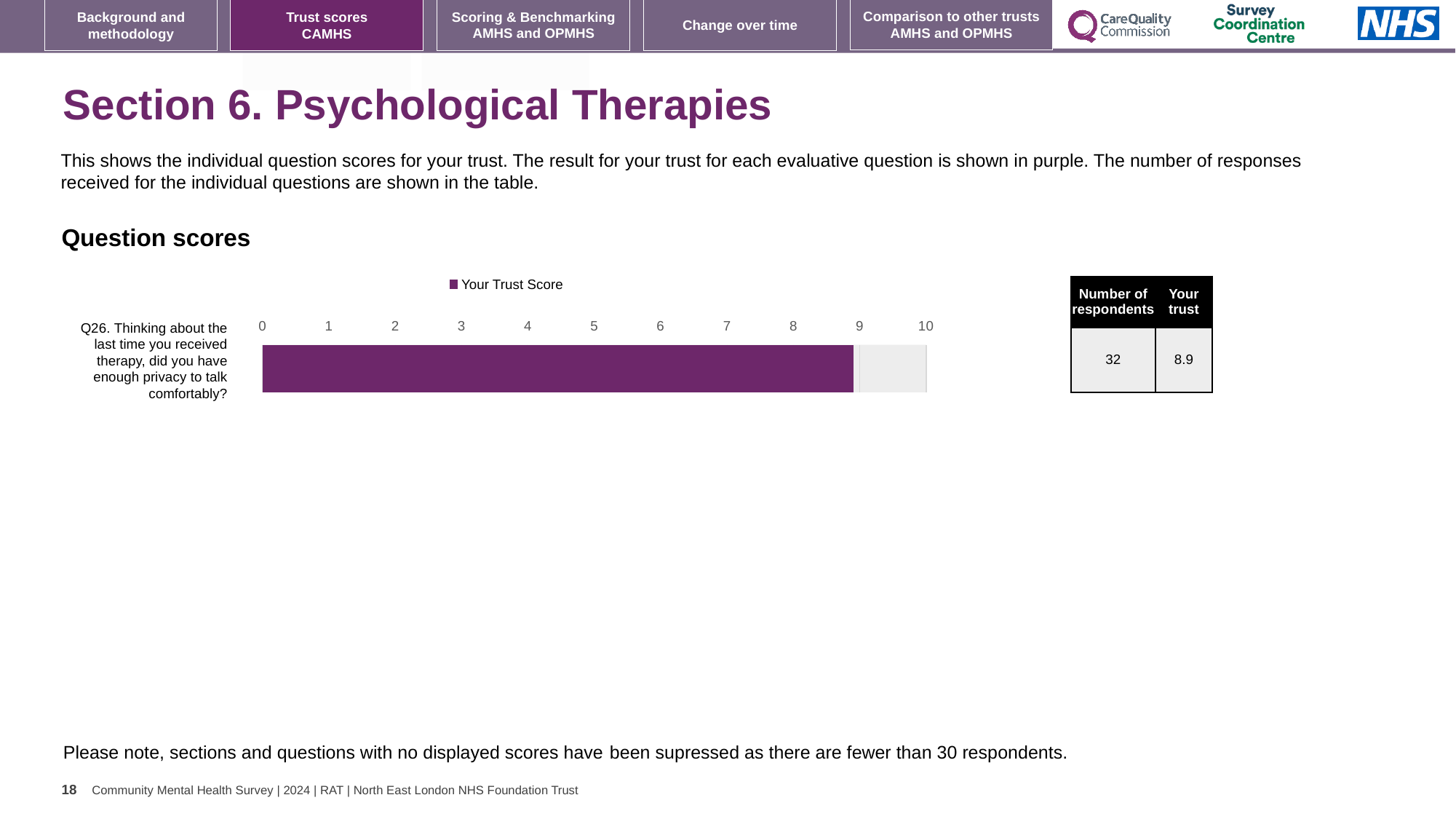
What is the trust score for Q26 in the Question scores chart? 8.9 How many respondents answered Q26 according to the table next to the chart? 32 Is the trust score for Q26 greater or less than 8? greater What is the maximum value shown on the x axis of the Question scores chart? 10 How many questions (categories) are plotted in the Question scores chart? 1 Which question is plotted in the Question scores chart? Q26. Thinking about the last time you received therapy, did you have enough privacy to talk comfortably? What is the name of the series shown in the legend of the Question scores chart? Your Trust Score Is the trust score for Q26 greater or less than 9? less How many series does the legend of the Question scores chart list? 1 What kind of chart is shown under 'Question scores'? bar chart